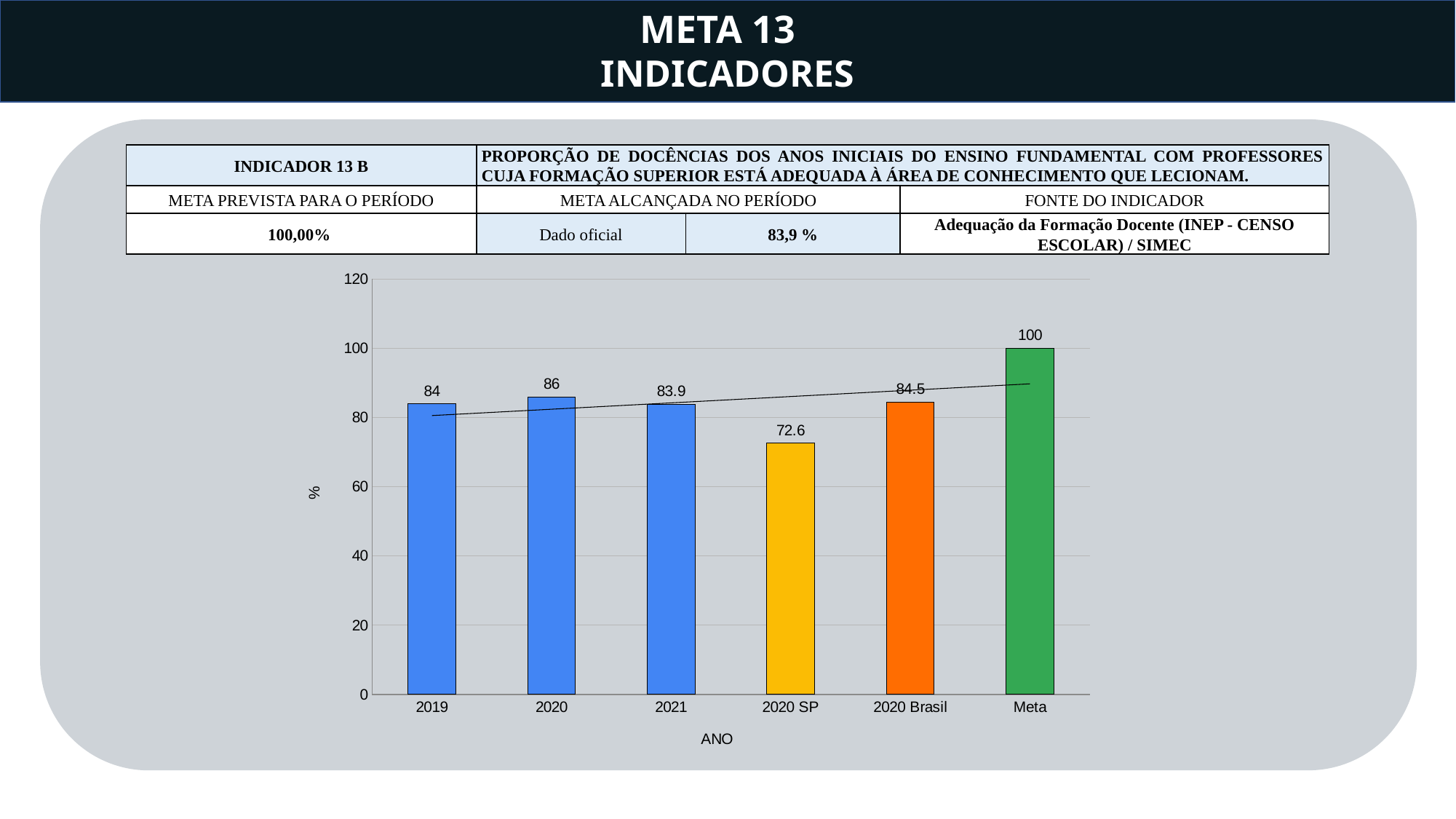
What is the value for 2020 Brasil in the chart? 84.5 Which category has the highest value in the chart? Meta What is the label of the y axis of the chart? % What is the value for 2020 SP in the chart? 72.6 What kind of chart is shown on the slide? bar chart What is the label of the x axis of the chart? ANO Which category has the lowest value in the chart? 2020 SP What is the value for 2021 in the chart? 83.9 What is the difference between the Meta value and the 2021 value? 16.1 How many bars are shown in the chart? 6 What is the value for 2019 in the chart? 84 Which is larger, the value for 2020 or the value for 2020 Brasil? 2020